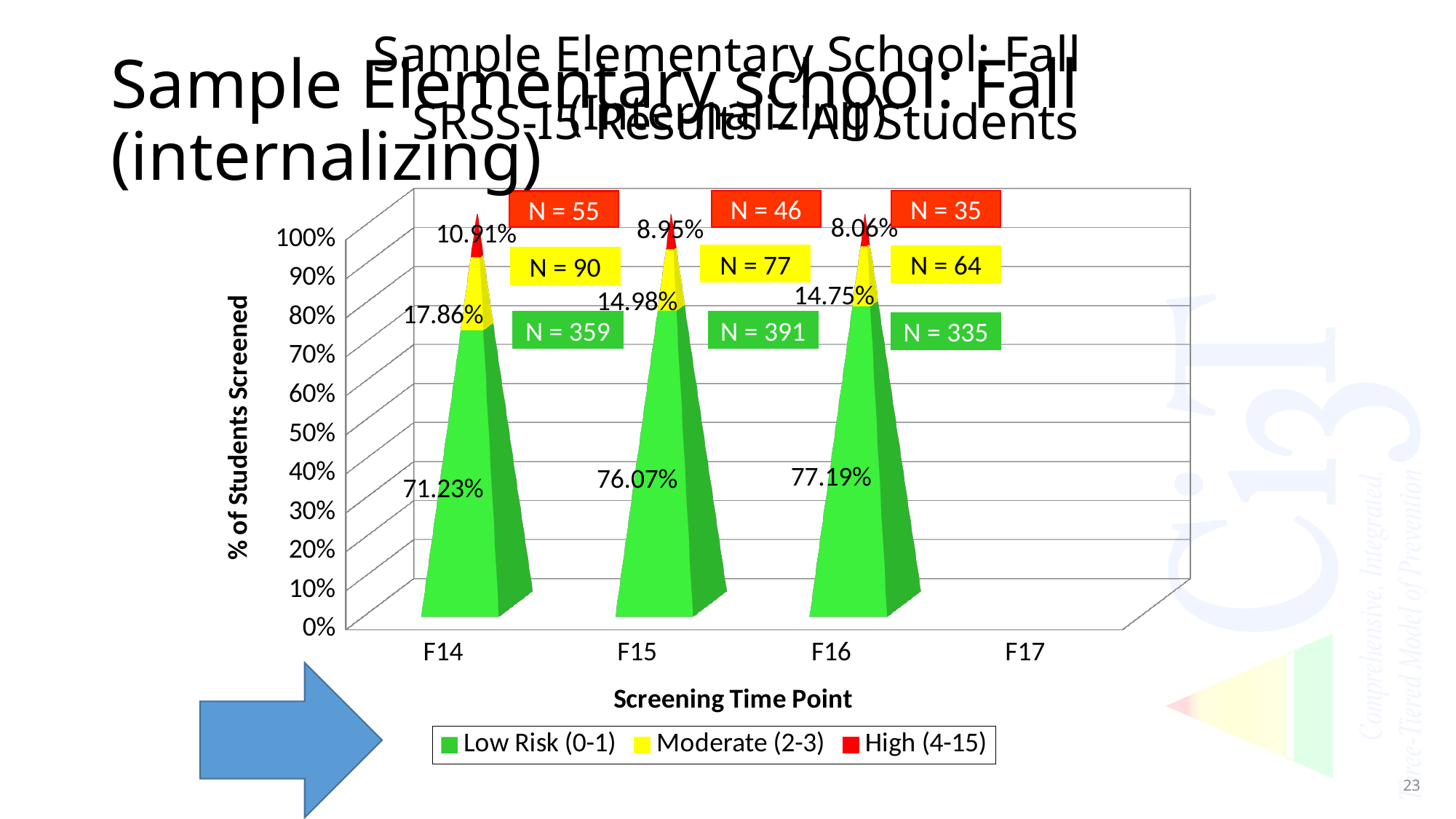
Is the Moderate (2-3) value larger for F14 or for F16? F14 Which screening time point has the lowest High (4-15) percentage? F16 What is the label of the y axis? % of Students Screened What is the High (4-15) value for F16? 8.06% What kind of chart is shown? stacked bar chart What is the difference between the Low Risk (0-1) values for F16 and F14? 5.96% What is the Low Risk (0-1) value for F14? 71.23% How many series does the legend list? 3 How many screening time points have data plotted? 3 Which screening time point has the highest Low Risk (0-1) percentage? F16 Does the Low Risk (0-1) percentage rise or fall from F14 to F16? rise What is the Moderate (2-3) value for F15? 14.98%